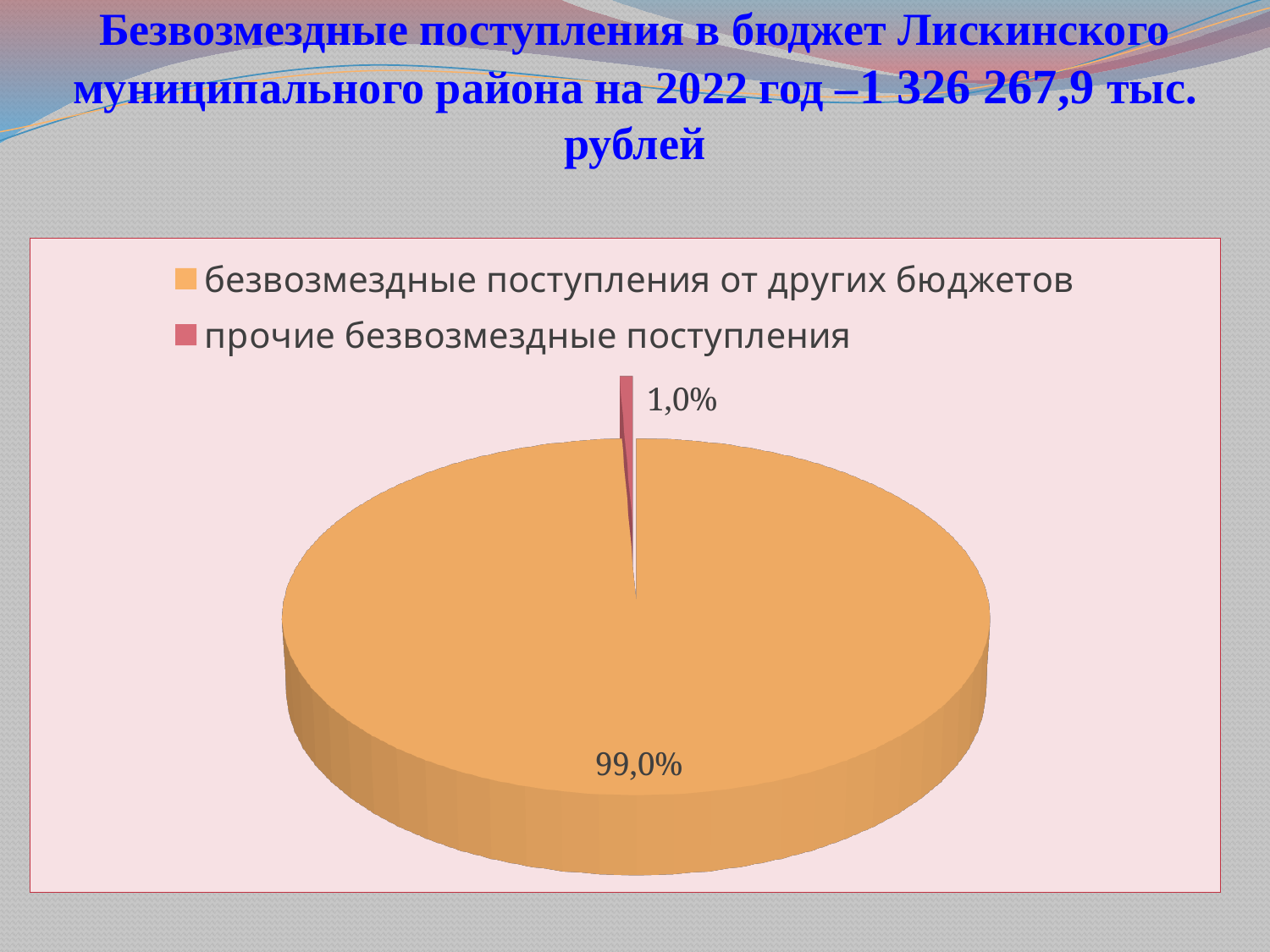
What kind of chart is shown on the slide? pie chart What is the difference in percentage points between the two slices? 98,0% What total amount of gratuitous receipts for 2022 is stated in the slide title? 1 326 267,9 тыс. рублей What share of the pie does 'прочие безвозмездные поступления' take? 1,0% Which category has the smallest slice of the pie? прочие безвозмездные поступления What colour is the slice for 'прочие безвозмездные поступления'? red (pink) How many slices does the pie chart have? 2 Which is larger: the slice for 'прочие безвозмездные поступления' or the slice for 'безвозмездные поступления от других бюджетов'? безвозмездные поступления от других бюджетов How many entries does the legend list? 2 Which category has the largest slice of the pie? безвозмездные поступления от других бюджетов What share of the pie does 'безвозмездные поступления от других бюджетов' take? 99,0%